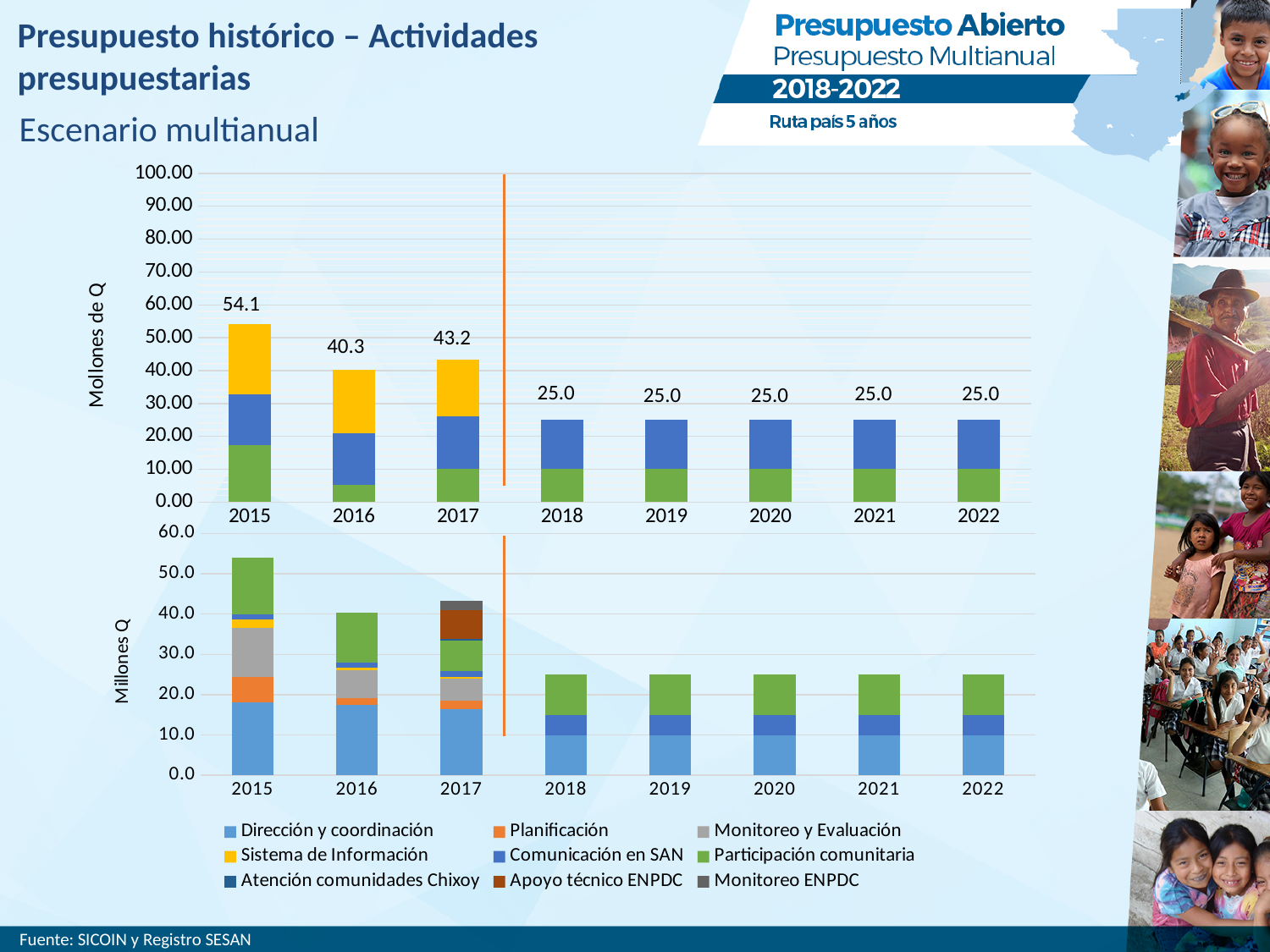
In the top chart, what is the total value labelled for 2015? 54.1 In the top chart, what is the difference between the labelled totals for 2015 and 2016? 13.8 How many years are shown on the x axis of the top chart? 8 In the bottom chart, is the total for the 2015 bar greater or less than 50.0? greater In the top chart, which labelled total is larger, 2016 or 2017? 2017 In the top chart, which year has the highest labelled total? 2015 In the bottom chart, is the total for the 2018 bar greater or less than 30.0? less How many series does the legend at the bottom of the slide list? 9 In the top chart, do the labelled totals rise or fall from 2015 to 2016? fall In the top chart, what is the total value labelled for 2017? 43.2 In the top chart, what is the difference between the labelled totals for 2017 and 2016? 2.9 In the top chart, what is the total value labelled for 2020? 25.0